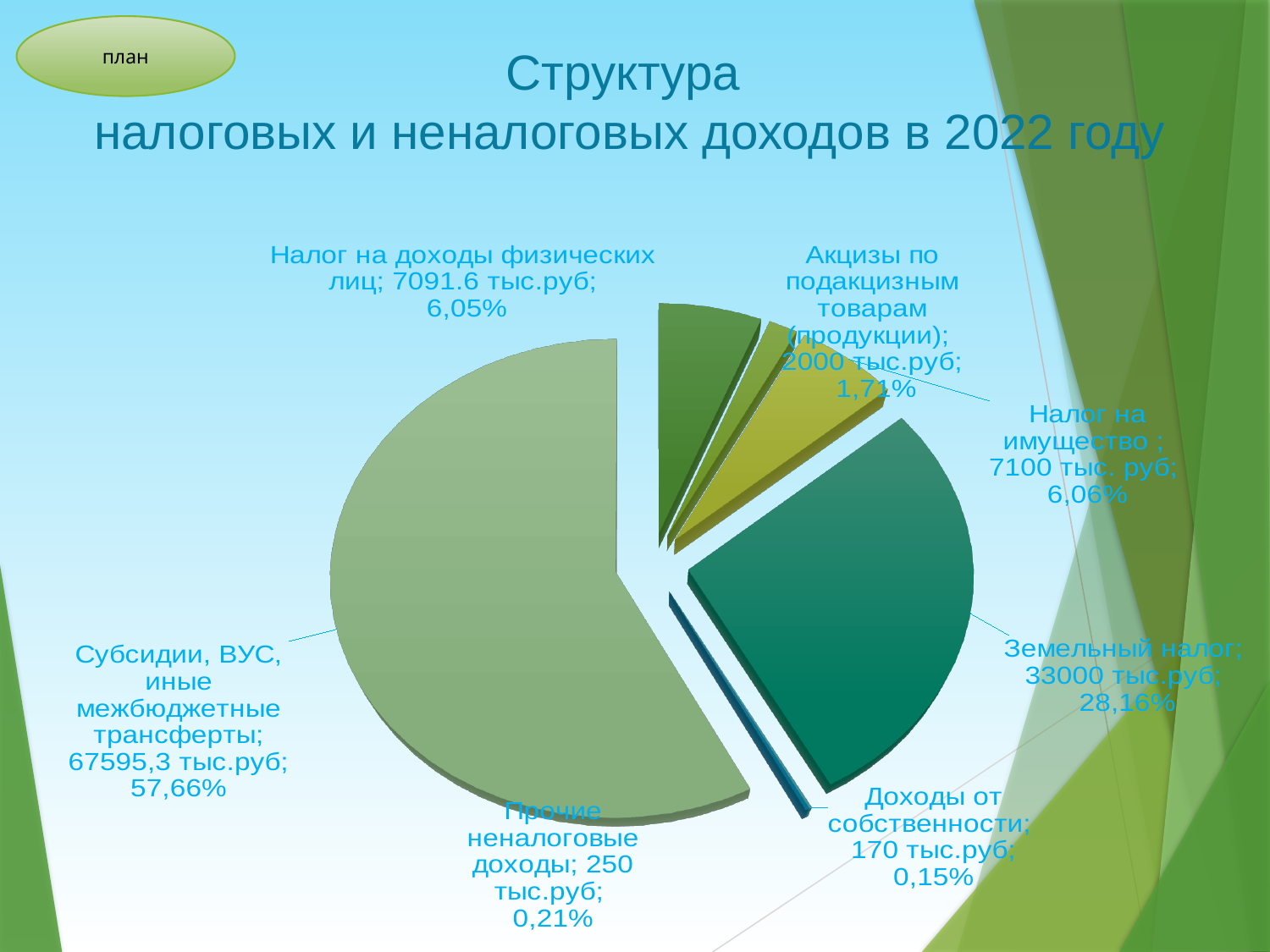
How many slices does the pie chart have? 7 What is the value for Земельный налог? 33000 тыс.руб What percentage is shown for Акцизы по подакцизным товарам (продукции)? 1,71% What is the title of the chart? Структура налоговых и неналоговых доходов в 2022 году What share of the pie does Налог на доходы физических лиц represent? 6,05% Which category has the largest slice of the pie? Субсидии, ВУС, иные межбюджетные трансферты What share of the pie does Субсидии, ВУС, иные межбюджетные трансферты represent? 57,66% Which category has the smallest slice of the pie? Доходы от собственности What is the difference in тыс.руб between Земельный налог and Налог на имущество? 25900 тыс.руб What kind of chart is shown on the slide? pie chart Which is larger, Земельный налог or Налог на имущество? Земельный налог What is the value for Прочие неналоговые доходы? 250 тыс.руб